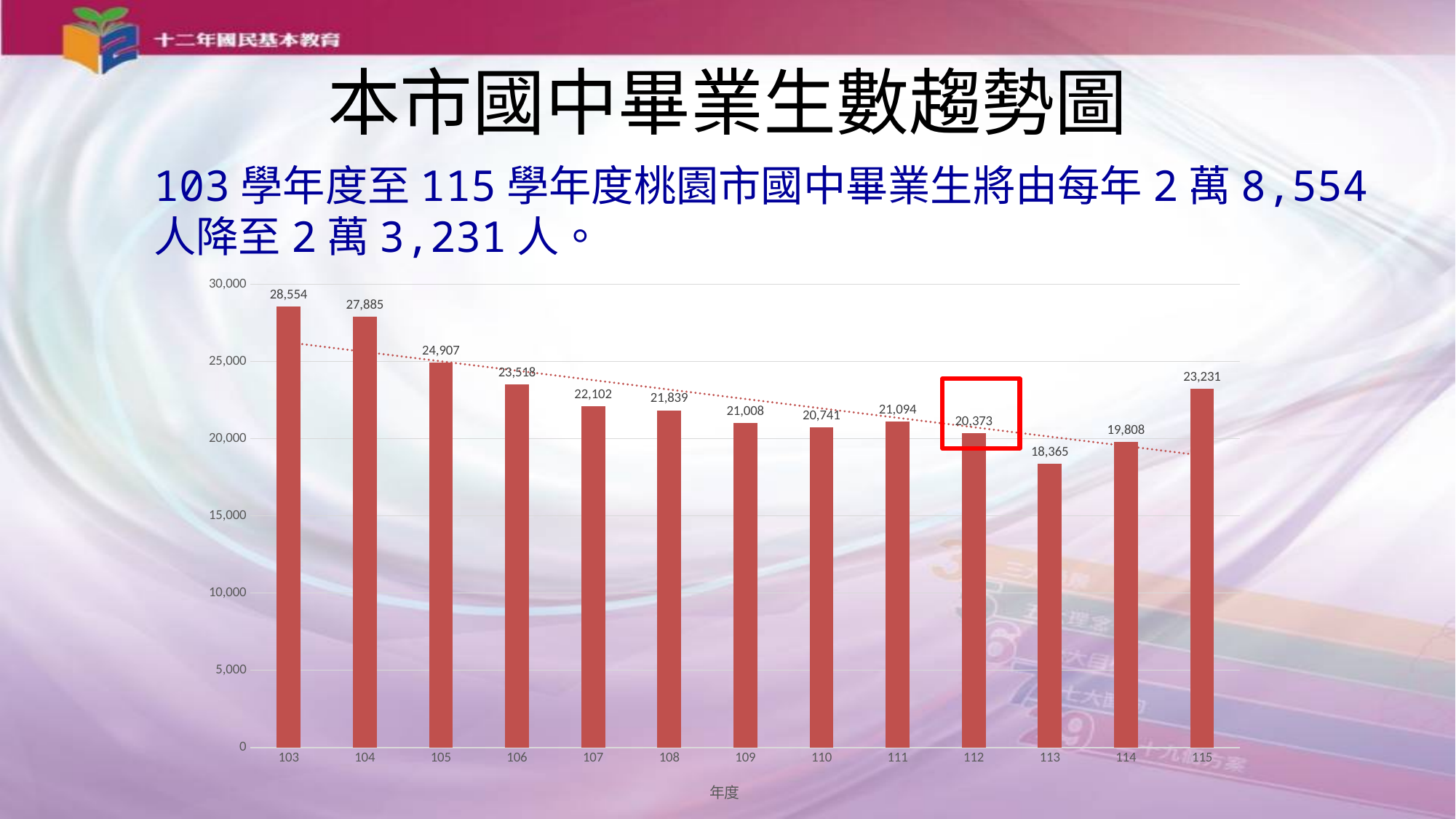
What is the value for year 103? 28,554 What is the label of the x axis? 年度 How many years are shown on the x axis? 13 Which year has the highest value? 103 What is the value for year 113? 18,365 What is the difference between the values for year 103 and year 115? 5,323 Which year has the lowest value? 113 What is the value for year 115? 23,231 What kind of chart is shown on the slide? bar chart Is the value for year 114 greater or less than 20,000? less Which is larger, the value for year 110 or the value for year 111? 111 What is the value for year 112, the bar highlighted with a red box? 20,373